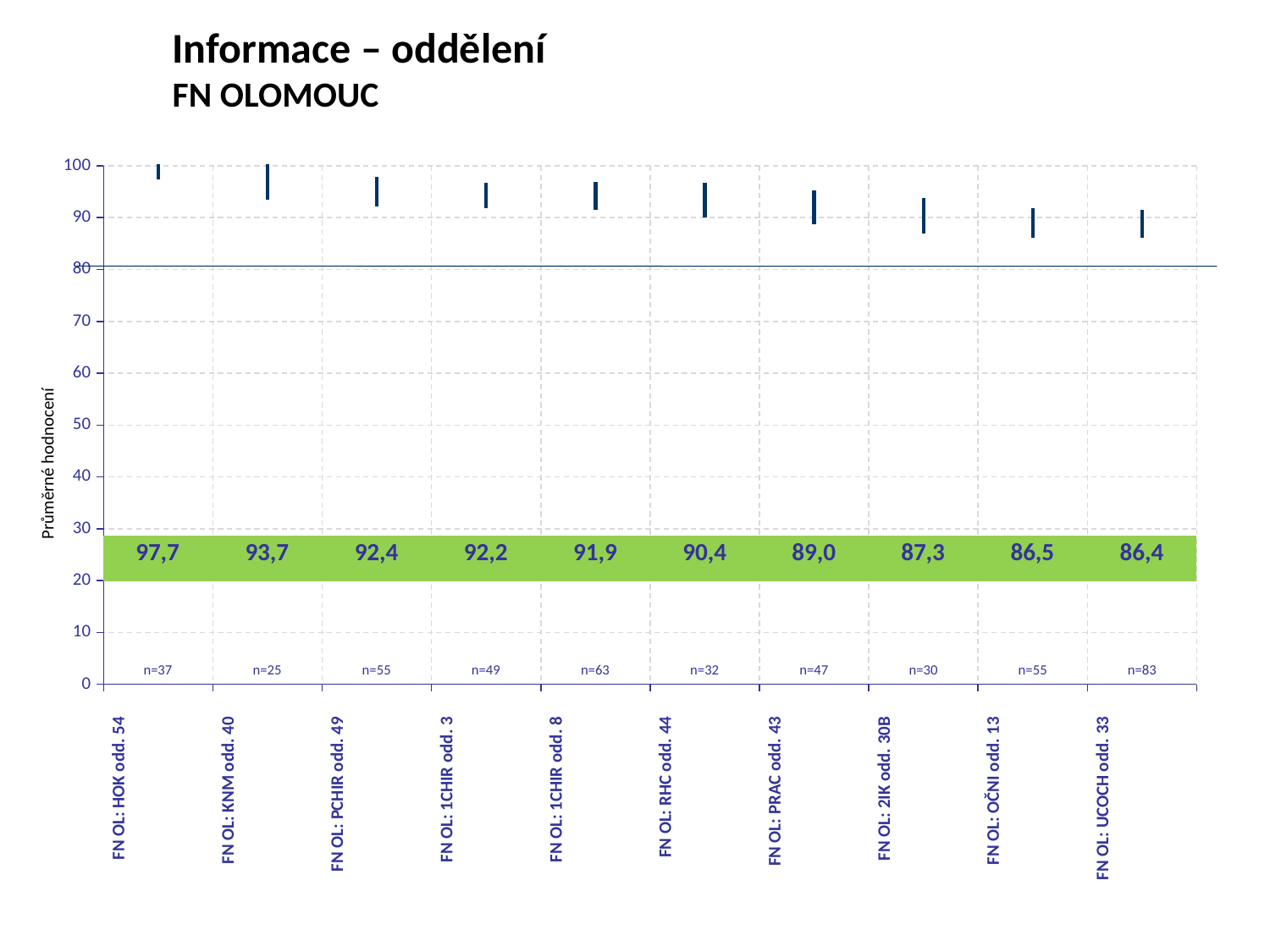
Which has a higher average rating, FN OL: PCHIR odd. 49 or FN OL: OČNI odd. 13? FN OL: PCHIR odd. 49 What is the average rating shown for FN OL: RHC odd. 44? 90,4 How many departments are shown on the chart? 10 What is the average rating (průměrné hodnocení) for FN OL: HOK odd. 54? 97,7 What is the sample size (n) shown for FN OL: UCOCH odd. 33? n=83 What is the difference between the average ratings of FN OL: KNM odd. 40 and FN OL: PRAC odd. 43? 4,7 Do the average ratings rise or fall from left to right along the x axis? fall What is the difference between the average ratings of FN OL: HOK odd. 54 and FN OL: UCOCH odd. 33? 11,3 What is the label of the vertical axis? Průměrné hodnocení Which department has the highest average rating? FN OL: HOK odd. 54 Which department has the lowest average rating? FN OL: UCOCH odd. 33 What is the average rating shown for FN OL: 2IK odd. 30B? 87,3